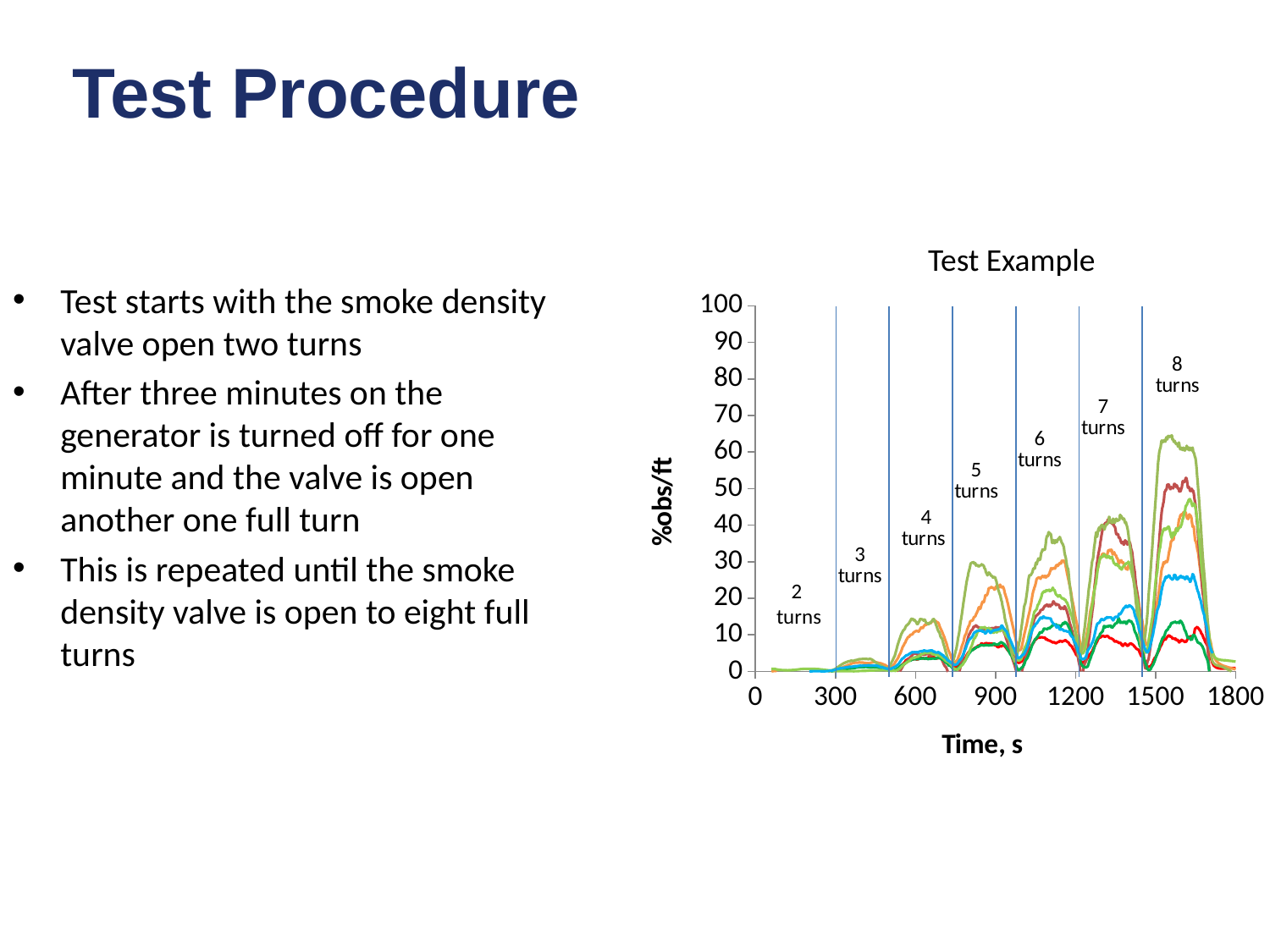
Are the values in the '2 turns' segment greater or less than 10 %obs/ft? less What is the title of the chart? Test Example What is the label of the y axis of the chart? %obs/ft Is the highest value on the whole chart greater or less than 70 %obs/ft? less In which labelled segment do the lines reach their highest values? 8 turns What is the label of the x axis of the chart? Time, s Is the peak of the red line in the '8 turns' segment greater or less than 20 %obs/ft? less Do the plotted values generally rise or fall as time increases along the x axis? rise What kind of chart is shown on the slide? line chart How many valve-turn segments are labelled on the chart? 7 What is the maximum value shown on the x axis? 1800